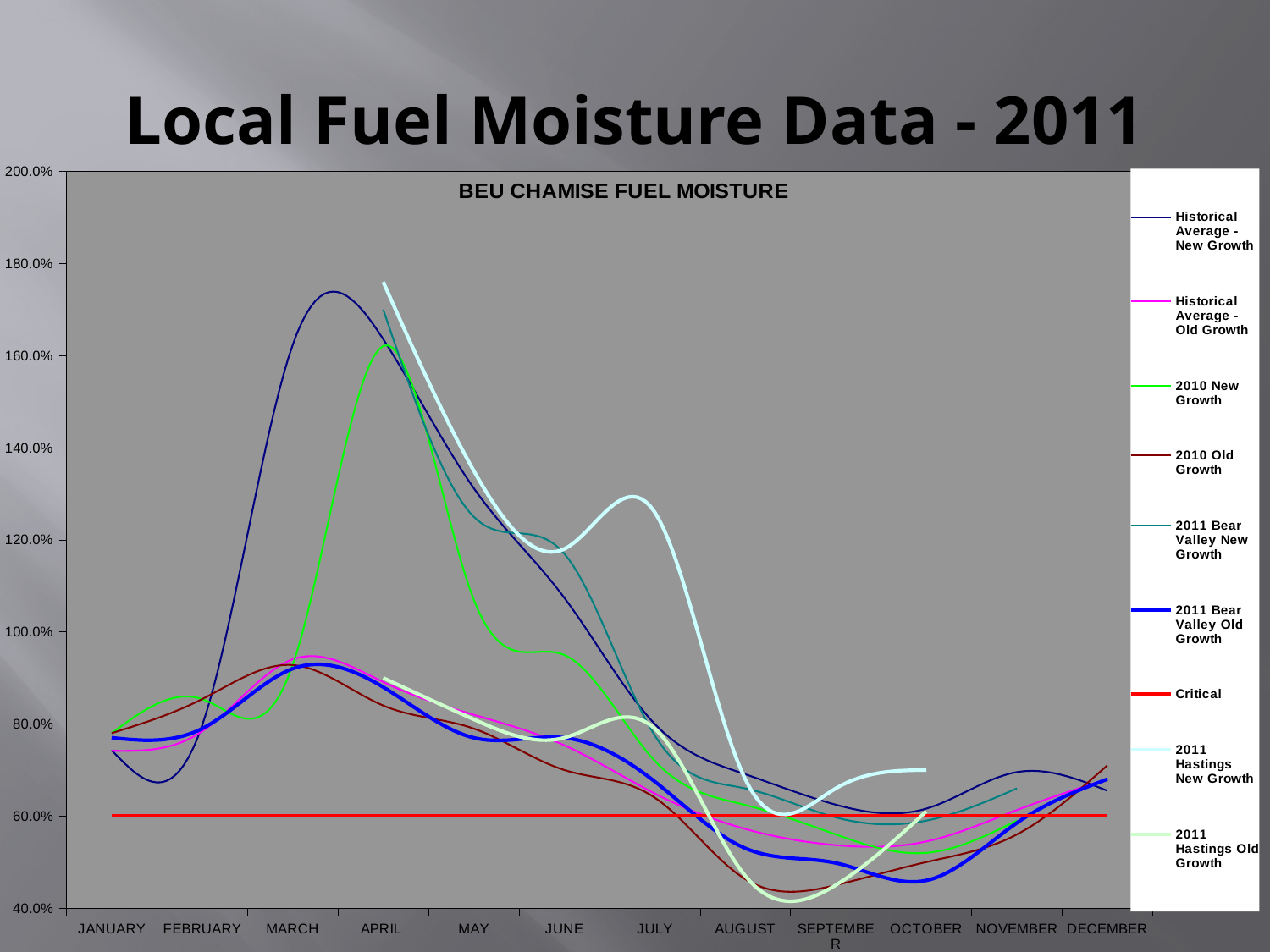
Is the value for 2011 Hastings New Growth in July greater or less than 120.0%? greater What kind of chart is shown on the slide? Line chart Is the value for 2010 New Growth in April greater or less than 140.0%? greater In April, which is higher: Historical Average - New Growth or Historical Average - Old Growth? Historical Average - New Growth How many months are shown along the x axis? 12 What value does the Critical line sit at? 60.0% What is the title of the chart? BEU CHAMISE FUEL MOISTURE Is the value for Historical Average - New Growth in March greater or less than 160.0%? greater Does the Historical Average - New Growth series rise or fall from April to September? Fall How many series does the legend list? 9